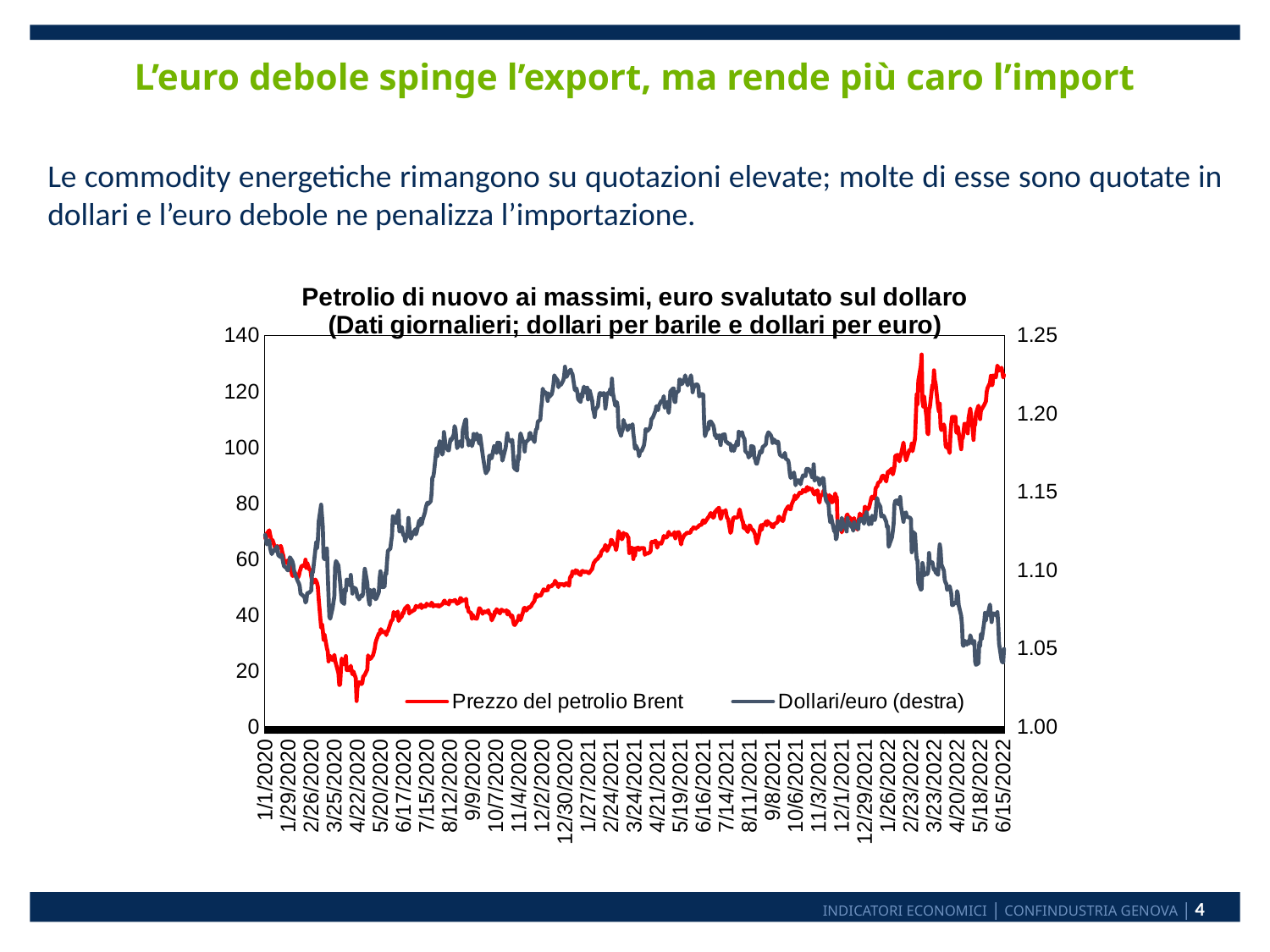
Is the value of Prezzo del petrolio Brent at 1/1/2020 greater or less than 80? less What is the title of the chart? Petrolio di nuovo ai massimi, euro svalutato sul dollaro (Dati giornalieri; dollari per barile e dollari per euro) Is the value of Prezzo del petrolio Brent at 9/9/2020 greater or less than 60? less Is the value of Dollari/euro at 12/30/2020 greater or less than 1.20? greater What kind of chart is shown on the slide? line chart Does the Dollari/euro series rise or fall between 1/26/2022 and 6/15/2022? fall Does the Prezzo del petrolio Brent series rise or fall overall between 11/4/2020 and 6/15/2022? rise Which series is plotted against the right-hand axis? Dollari/euro (destra) How many series does the chart's legend list? 2 Does the Prezzo del petrolio Brent series rise or fall between 1/1/2020 and 4/22/2020? fall